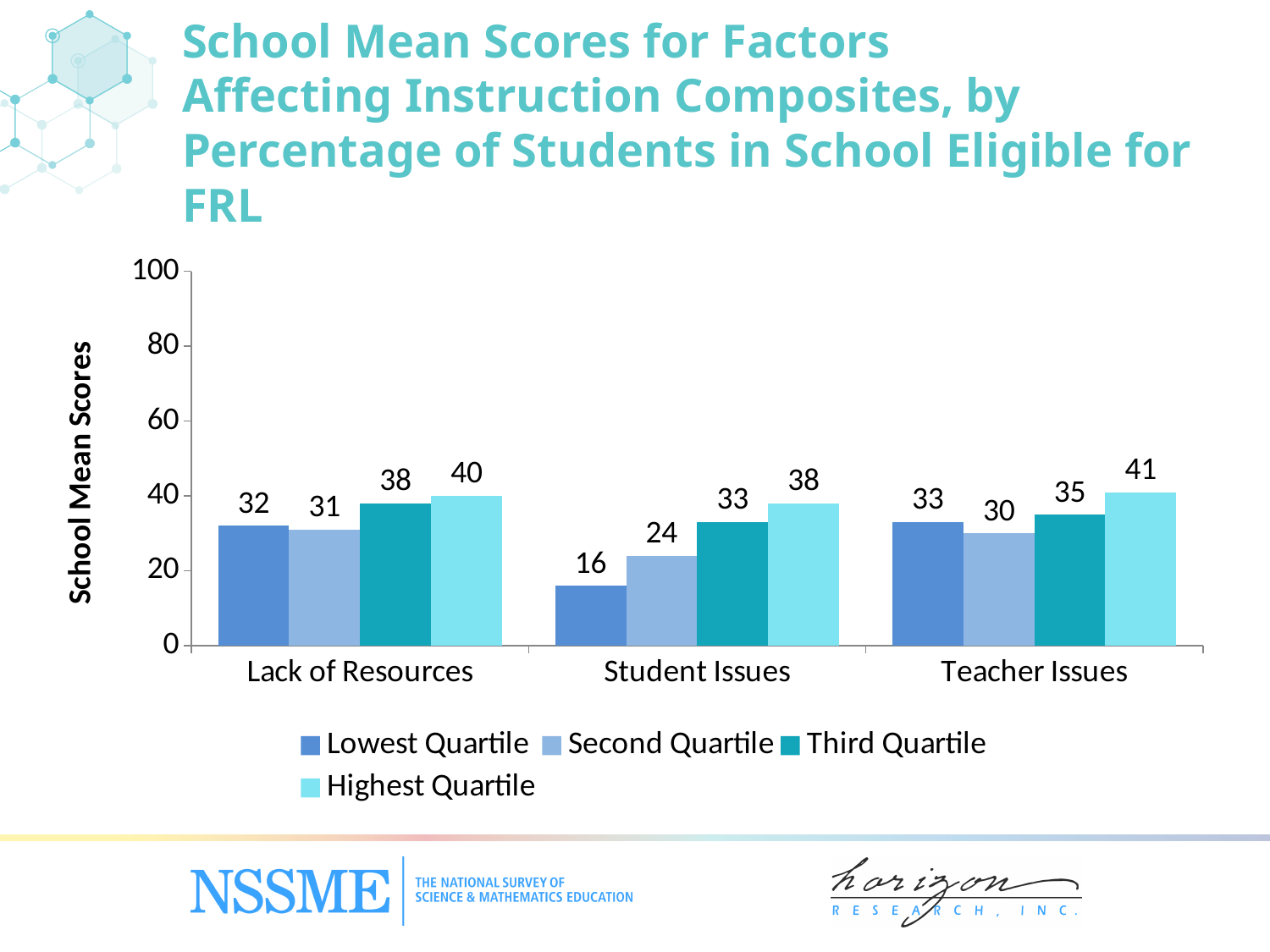
Which is larger: the Third Quartile score for Lack of Resources or the Third Quartile score for Teacher Issues? Lack of Resources What is the school mean score for Student Issues in the Second Quartile? 24 What is the school mean score for Lack of Resources in the Lowest Quartile? 32 Is the Lowest Quartile score for Student Issues greater or less than 20? less What is the label of the y axis? School Mean Scores What is the difference between the Highest Quartile and Lowest Quartile scores for Student Issues? 22 Which quartile has the highest school mean score for Lack of Resources? Highest Quartile Which quartile has the lowest school mean score for Student Issues? Lowest Quartile How many categories are shown on the x axis? 3 What kind of chart is shown on the slide? Bar chart What is the school mean score for Teacher Issues in the Highest Quartile? 41 How many series does the legend list? 4